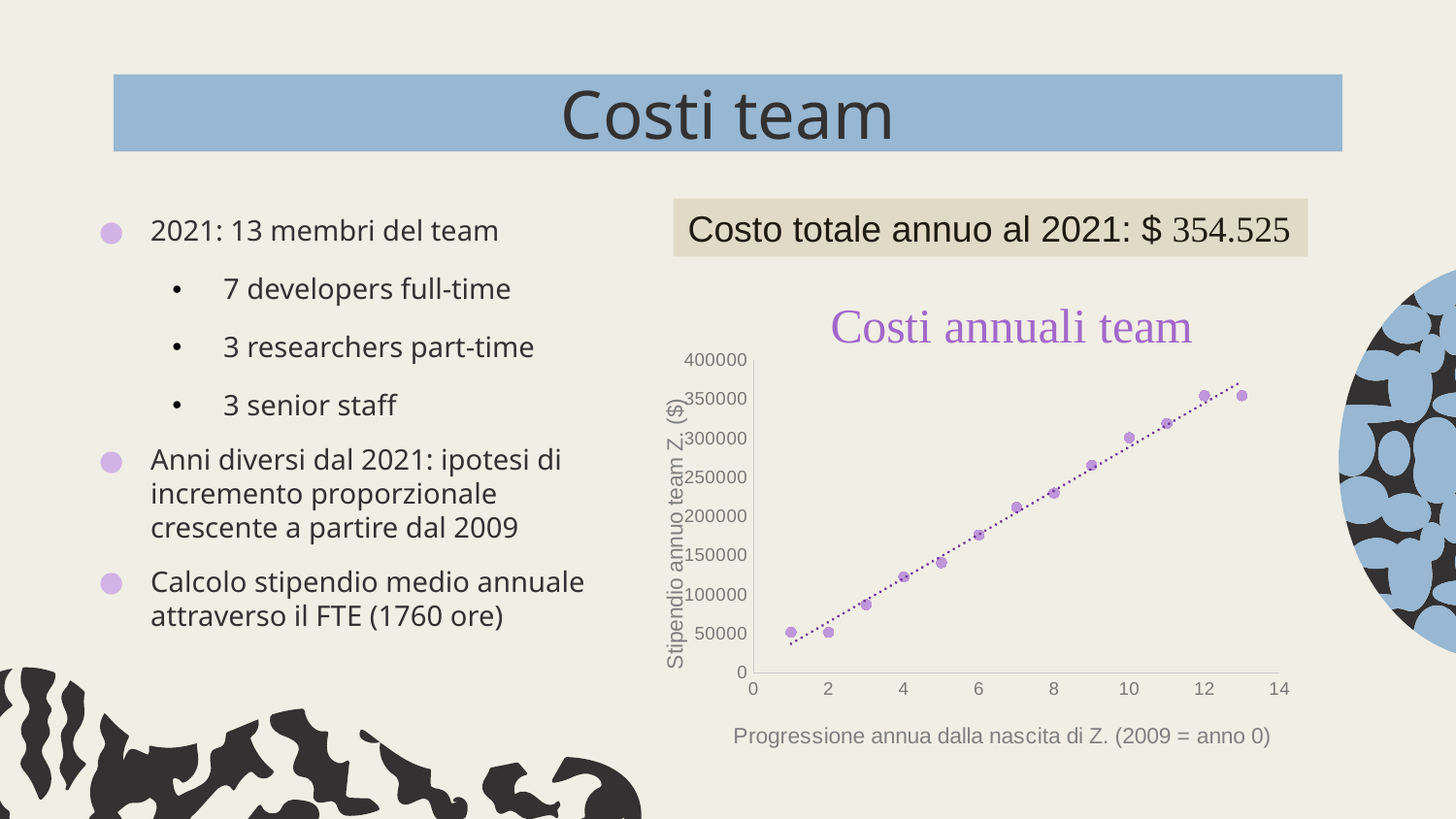
Is the value at year 10 greater or less than 250000? greater Is the value at year 4 greater or less than 150000? less What is the title of the chart? Costi annuali team Which is larger, the value at year 4 or the value at year 10? year 10 Which is larger, the value at year 3 or the value at year 8? year 8 What is the label of the vertical axis of the chart? Stipendio annuo team Z. ($) Do the plotted values rise or fall as the year progression increases along the x axis? rise What kind of chart is shown on the slide? scatter chart How many data points are plotted in the chart? 13 Is the value at year 13 greater or less than 300000? greater